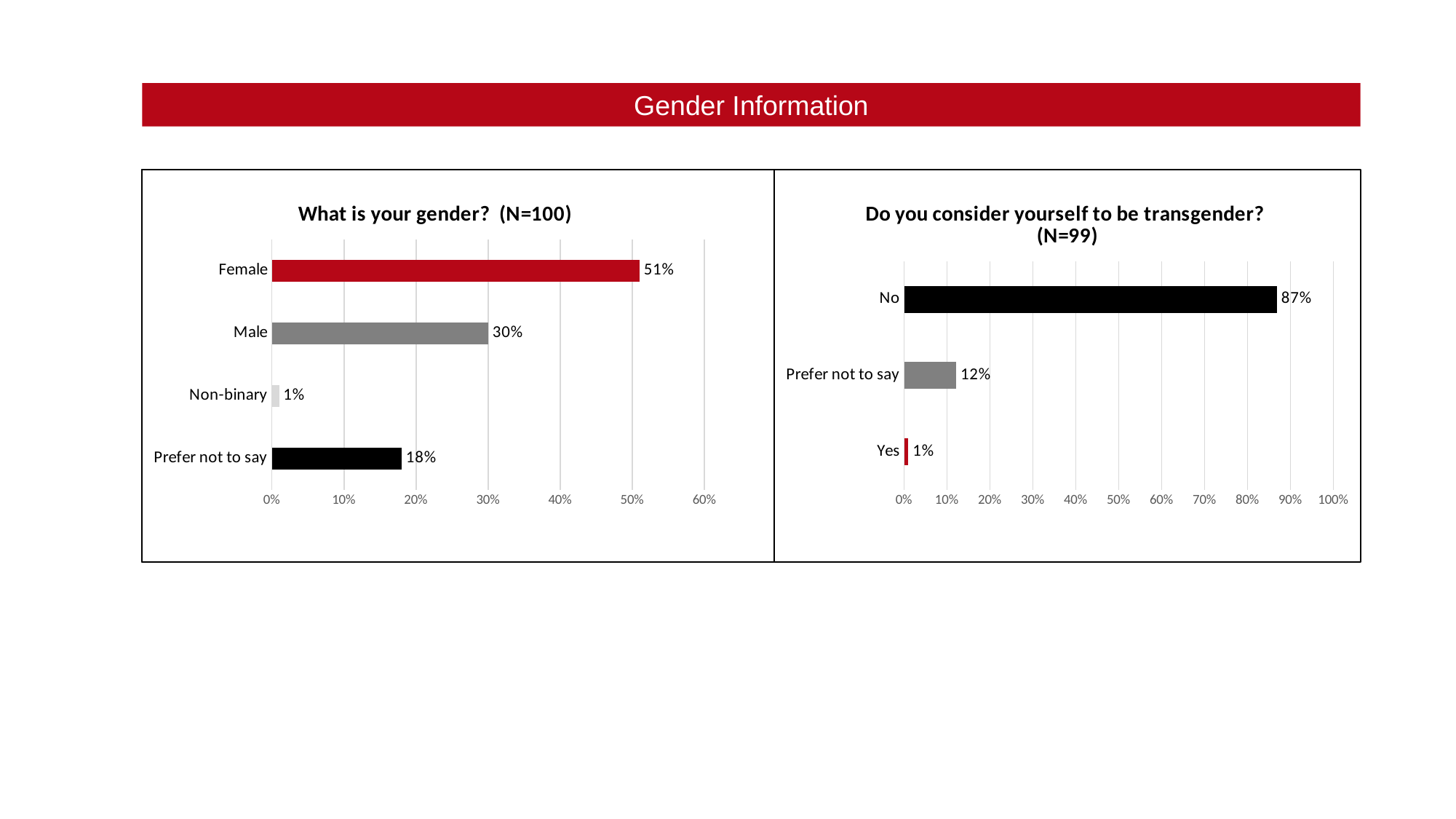
In the 'What is your gender?' chart, what is the difference between the Female and Male values? 21% In the 'Do you consider yourself to be transgender?' chart, what is the value for No? 87% In the 'What is your gender?' chart, what is the value for Prefer not to say? 18% What type of chart is the 'Do you consider yourself to be transgender?' chart? Bar chart In the 'What is your gender?' chart, which category has the lowest value? Non-binary In the 'Do you consider yourself to be transgender?' chart, which category has the highest value? No In the 'Do you consider yourself to be transgender?' chart, what is the value for Prefer not to say? 12% In the 'What is your gender?' chart, which is larger, Male or Prefer not to say? Male In the 'What is your gender?' chart, what percentage of respondents are Female? 51% In the 'What is your gender?' chart, how many categories are shown? 4 What is the sample size (N) shown in the title of the 'Do you consider yourself to be transgender?' chart? 99 In the 'Do you consider yourself to be transgender?' chart, what is the difference between No and Yes? 86%